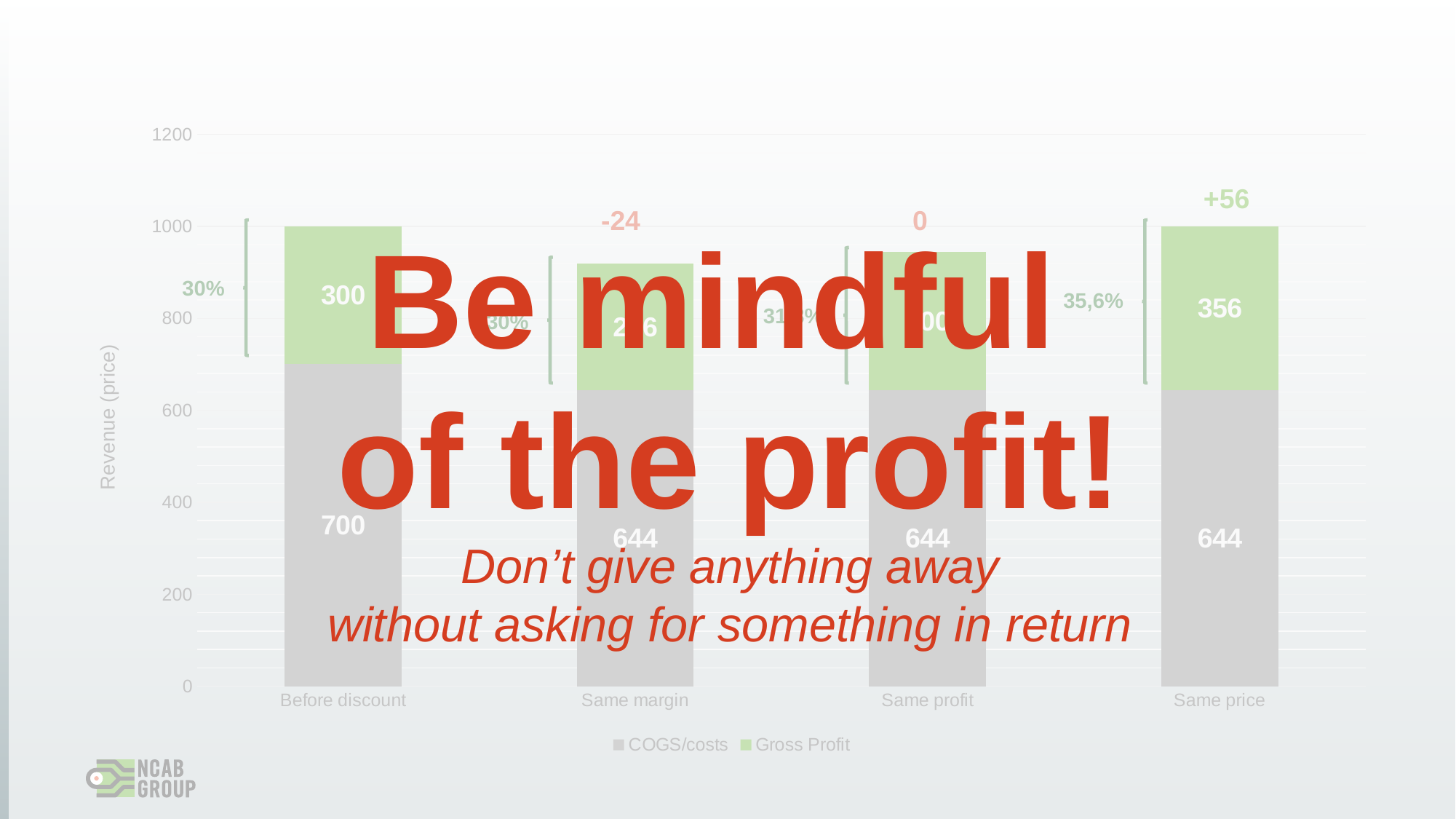
What is the difference between the Gross Profit of the Same price bar and the Before discount bar? 56 How many categories are shown on the x axis of the chart? 4 Is the total of the Same margin stacked bar greater or less than 1000? less What is the total height of the Before discount stacked bar? 1000 What is the COGS/costs value for the Same price bar? 644 What is the Gross Profit value for the Before discount bar? 300 Which category has the highest COGS/costs value? Before discount What is the label of the y axis of the chart? Revenue (price) What kind of chart is shown on the slide? Stacked bar chart What is the Gross Profit value for the Same price bar? 356 How many series does the chart legend list? 2 What is the COGS/costs value for the Before discount bar? 700